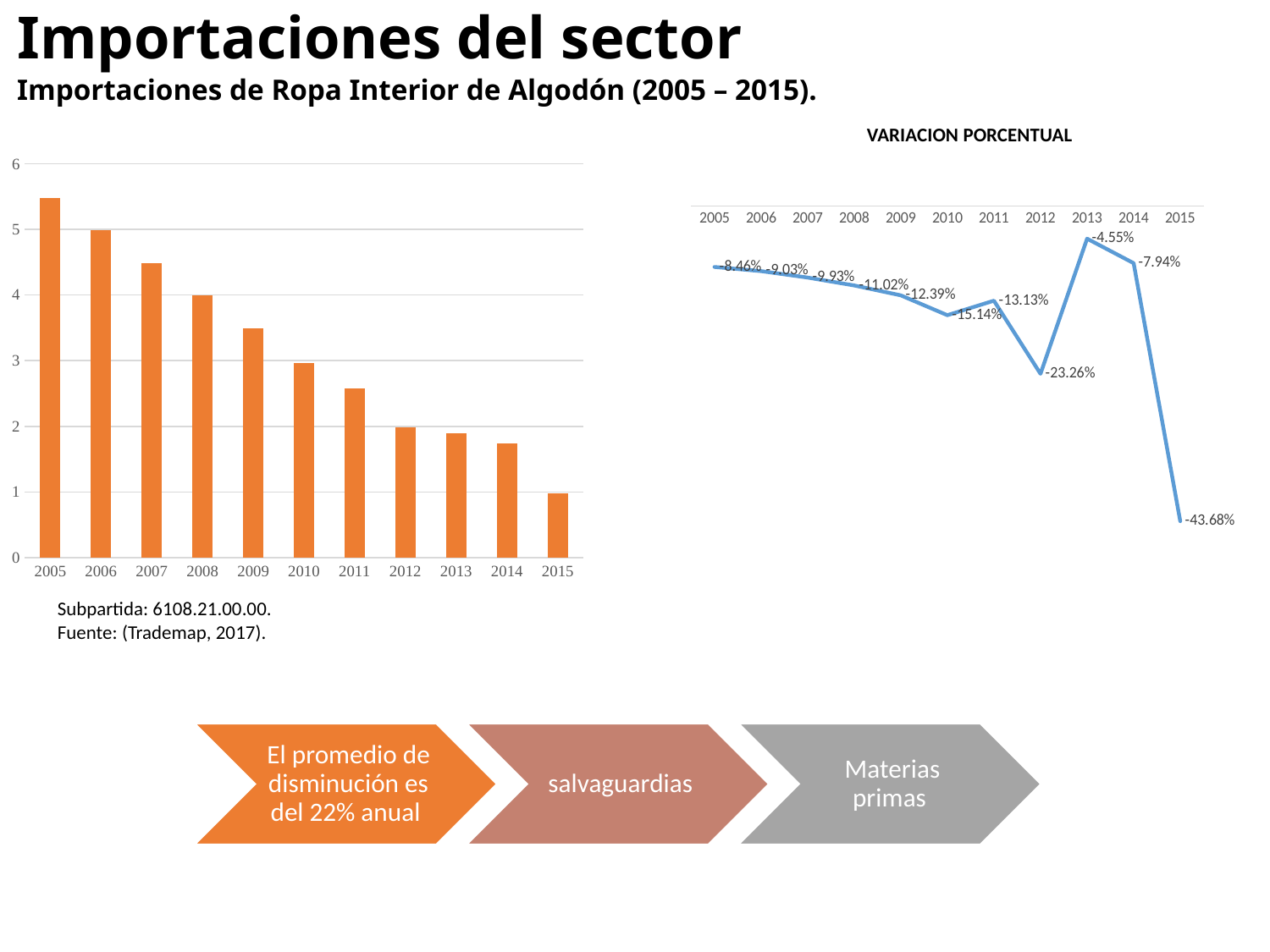
How many years are shown on the x axis of the bar chart on the left? 11 In the bar chart on the left, is the value for 2005 greater or less than 5? greater In the bar chart on the left, do the values rise or fall from 2005 to 2015? fall In the VARIACION PORCENTUAL chart, which year has the highest value? 2013 What type of chart is the VARIACION PORCENTUAL chart? line chart In the bar chart on the left, is the value for 2012 greater or less than 3? less In the VARIACION PORCENTUAL chart, what is the value for 2015? -43.68% In the VARIACION PORCENTUAL chart, what is the value for 2012? -23.26% In the VARIACION PORCENTUAL chart, what is the difference between the values for 2013 and 2014? 3.39% In the bar chart on the left, which year has the highest bar? 2005 In the bar chart on the left, which year has the lowest bar? 2015 What type of chart is the chart on the left of the slide? bar chart